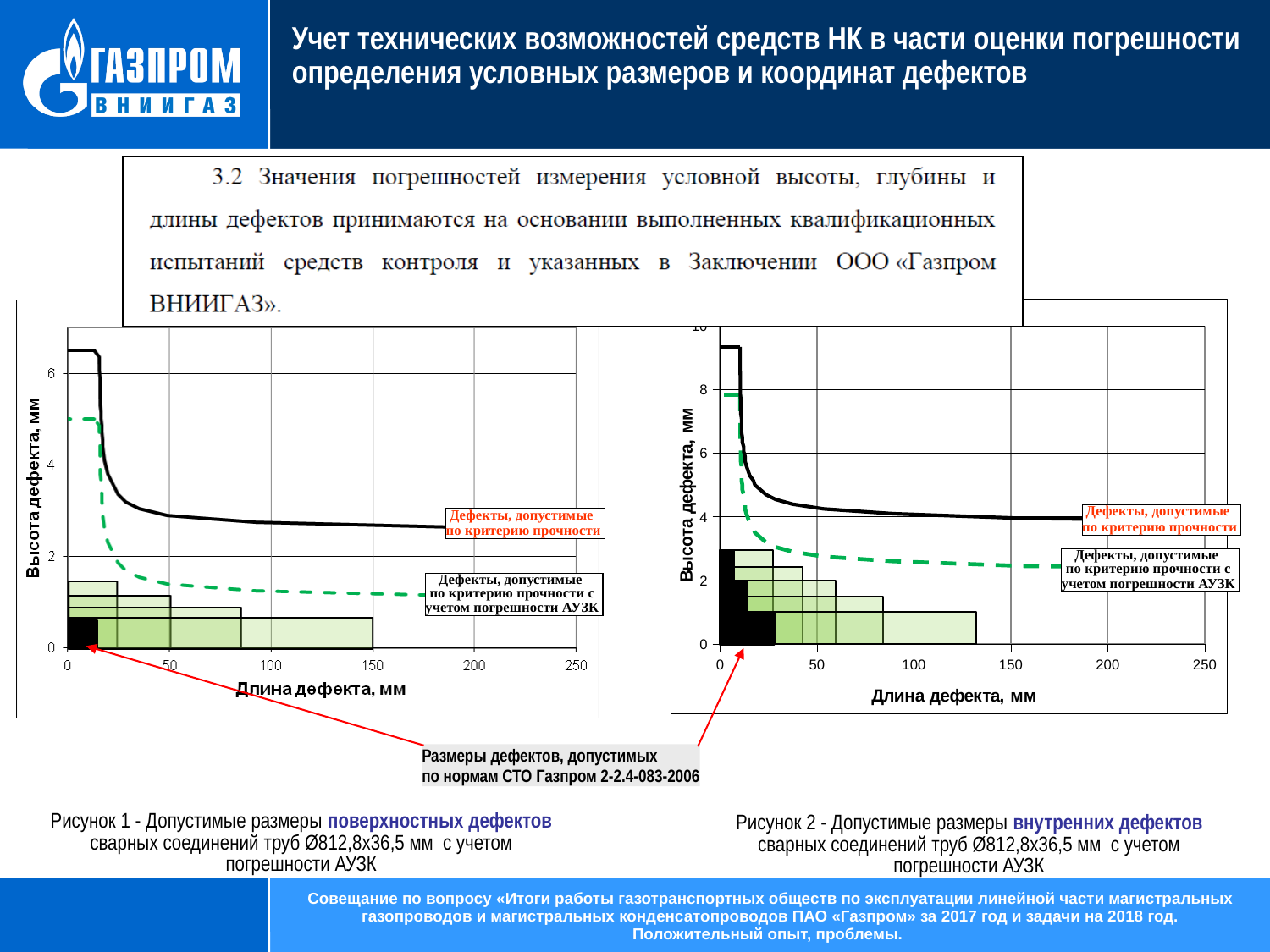
What kind of chart is Рисунок 1 (the left chart)? Line chart What is the x-axis title of Рисунок 2 (the right chart)? Длина дефекта, мм In Рисунок 1 (the left chart), at a defect length of 100 mm, which curve is higher: the solid black curve or the dashed green curve? The solid black curve In Рисунок 2 (the right chart), at a defect length of 100 mm, which curve is higher: the solid black curve or the dashed green curve? The solid black curve In Рисунок 2 (the right chart), is the value of the dashed green curve at a defect length of 200 mm greater or less than 4? less What is the y-axis title of Рисунок 1 (the left chart)? Высота дефекта, мм In Рисунок 1 (the left chart), is the value of the dashed green curve at a defect length of 200 mm greater or less than 2? less In Рисунок 1 (the left chart), does the solid black curve rise or fall as defect length increases? Falls In Рисунок 1 (the left chart), is the value of the solid black curve at a defect length of 200 mm greater or less than 4? less In Рисунок 2 (the right chart), does the dashed green curve rise or fall as defect length increases? Falls What is the largest tick value shown on the x-axis of Рисунок 1 (the left chart)? 250